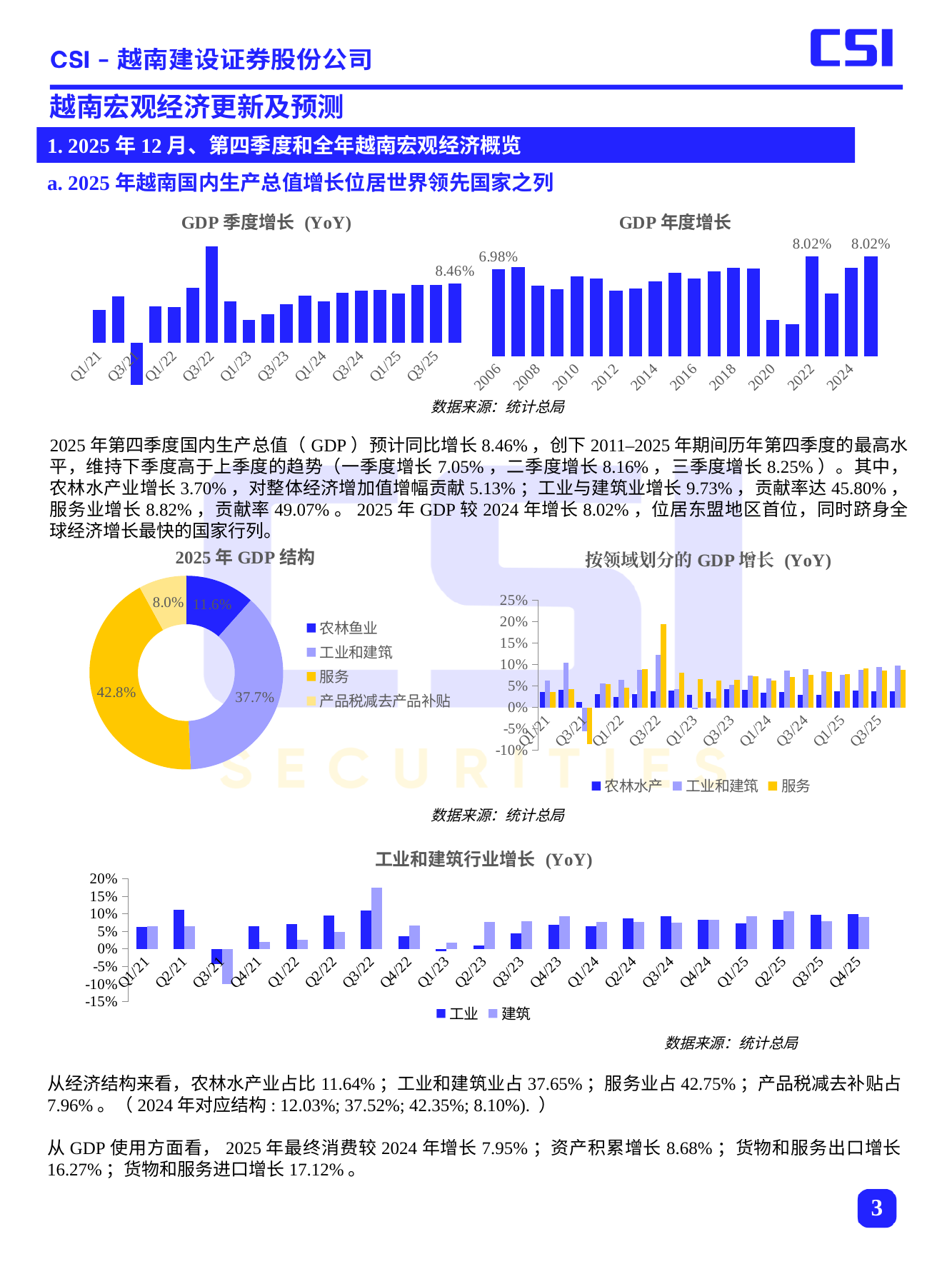
In the '2025 年 GDP 结构' chart, what share does 服务 have? 42.8% In the '2025 年 GDP 结构' chart, which category has the smallest slice? 产品税减去产品补贴 In the 'GDP 年度增长' chart, how many years are plotted? 20 In the '2025 年 GDP 结构' chart, what is the difference between the 服务 share and the 工业和建筑 share? 5.1 percentage points In the '按领域划分的 GDP 增长 (YoY)' chart, how many series does the legend list? 3 In the 'GDP 年度增长' chart, which year has the lowest value? 2021 In the 'GDP 季度增长 (YoY)' chart, which quarter has the highest bar? Q3/22 In the 'GDP 季度增长 (YoY)' chart, which quarter has the lowest value? Q3/21 In the 'GDP 季度增长 (YoY)' chart, what is the value printed for the last quarter (Q4/25)? 8.46% In the '工业和建筑行业增长 (YoY)' chart, is the value for 建筑 in Q3/21 greater or less than -5%? less In the 'GDP 年度增长' chart, what value is printed for 2025? 8.02% In the '按领域划分的 GDP 增长 (YoY)' chart, is the value for 服务 in Q3/22 greater or less than 15%? greater